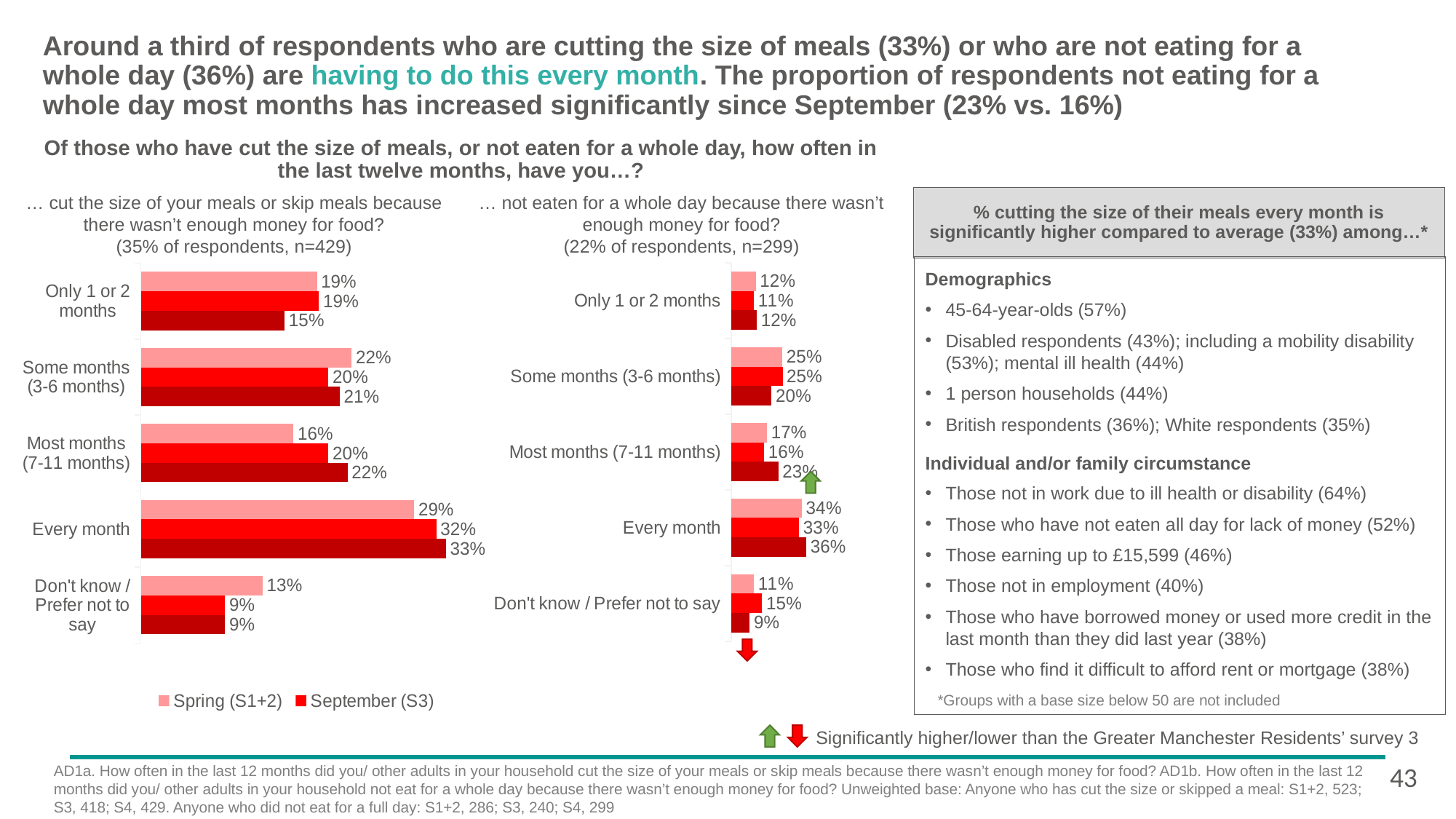
In the left chart (cut the size of your meals or skip meals), how many percentage points higher is the September (S3) value than the Spring (S1+2) value for Every month? 3 percentage points What kind of chart is the left chart (cut the size of your meals or skip meals)? Bar chart In the left chart (cut the size of your meals or skip meals), what is the value of the bottom (dark red) bar for Most months (7-11 months)? 22% In the right chart (not eaten for a whole day), which has the larger Spring (S1+2) value: Some months (3-6 months) or Most months (7-11 months)? Some months (3-6 months) How many series does the legend list? 2 In the right chart (not eaten for a whole day), how many percentage points higher is the September (S3) value than the Spring (S1+2) value for Don't know / Prefer not to say? 4 percentage points What are the two entries in the legend? Spring (S1+2) and September (S3) In the right chart (not eaten for a whole day), what is the September (S3) value for Most months (7-11 months)? 16% In the left chart (cut the size of your meals or skip meals), how many categories are shown? 5 In the left chart (cut the size of your meals or skip meals), which category has the highest September (S3) value? Every month In the left chart (cut the size of your meals or skip meals), what is the Spring (S1+2) value for Every month? 29% In the right chart (not eaten for a whole day), which category has the lowest Spring (S1+2) value? Don't know / Prefer not to say